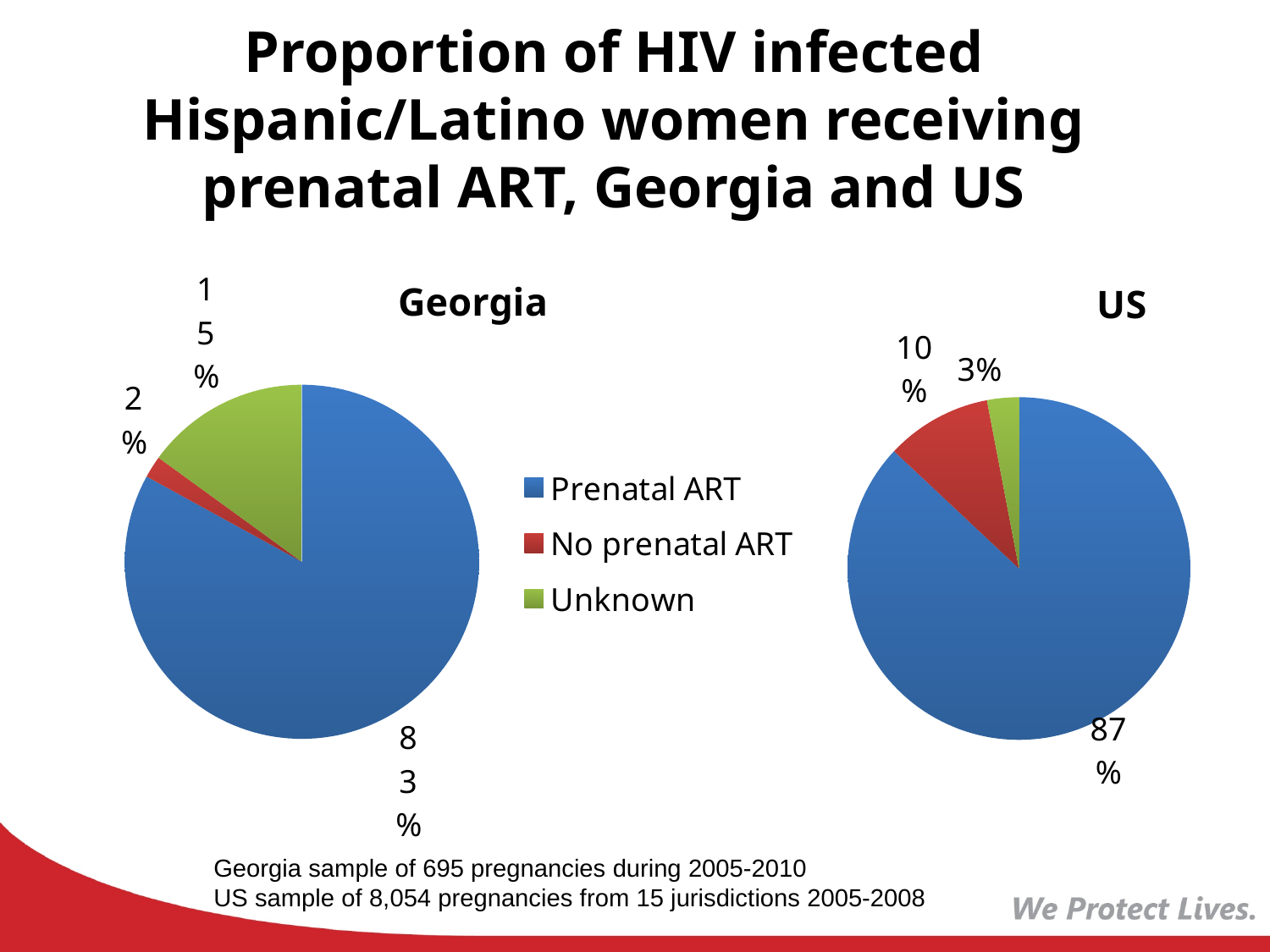
What is the difference between the US and Georgia percentages for Prenatal ART? 4% Which has a larger share of No prenatal ART, Georgia or the US? US In the US pie chart, what is the share for No prenatal ART? 10% How many categories does the legend list? 3 In the Georgia pie chart, which category has the smallest slice? No prenatal ART In the Georgia pie chart, what is the share for No prenatal ART? 2% In the US pie chart, what percentage of women received prenatal ART? 87% In the Georgia pie chart, what is the share for Unknown? 15% In the US pie chart, which category has the largest slice? Prenatal ART In the US pie chart, what is the share for Unknown? 3% What type of chart is used on this slide? Pie chart In the Georgia pie chart, what percentage of women received prenatal ART? 83%